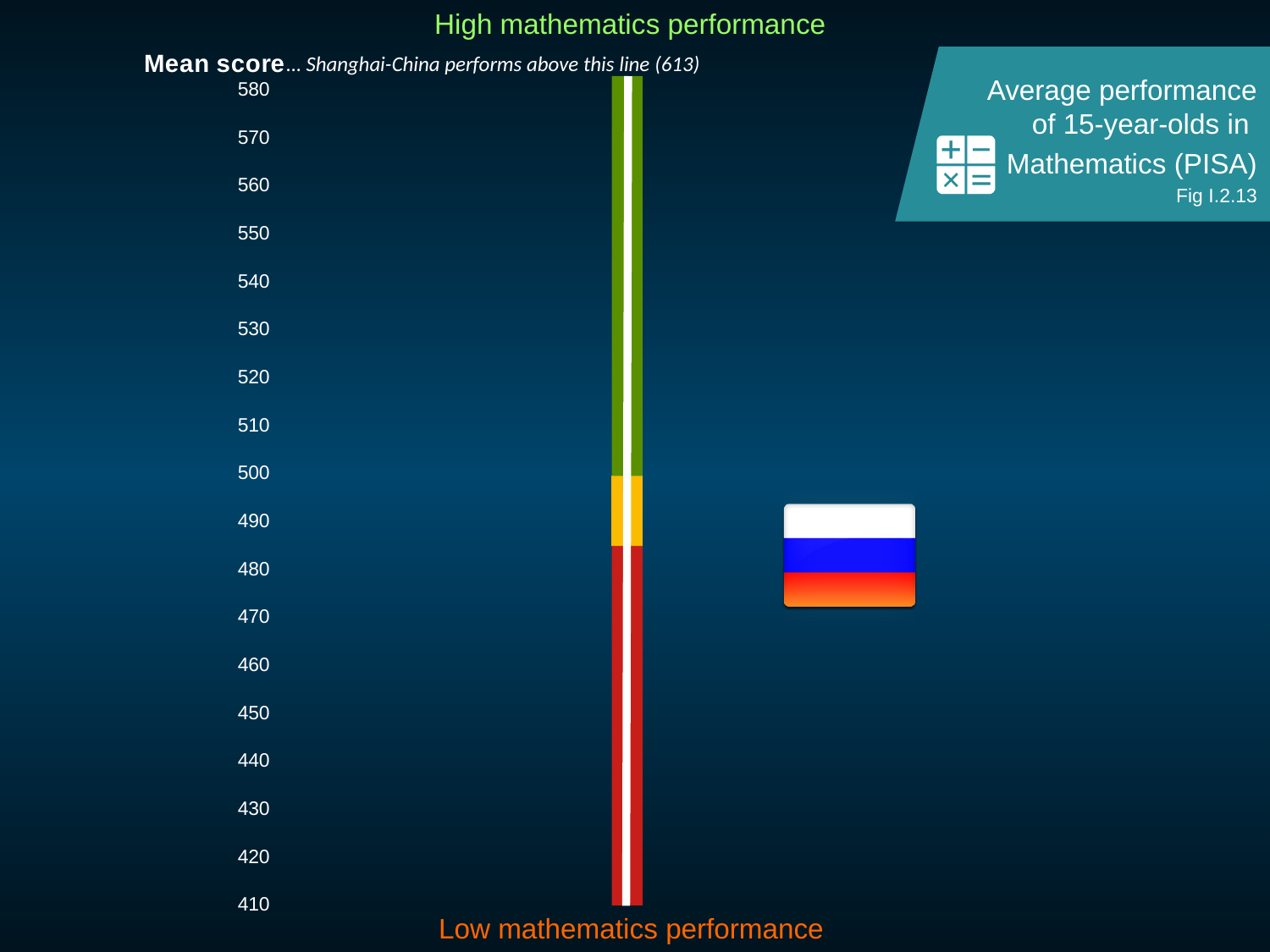
Is the position of the Russian flag on the scale greater or less than 500? less What is the lowest value shown on the vertical scale? 410 What is the interval between consecutive tick labels on the vertical scale? 10 What label appears at the bottom of the scale? Low mathematics performance How many tick labels are printed on the vertical scale? 18 Is the position of the Russian flag on the scale greater or less than 450? greater What is the figure number given in the box on the right? Fig I.2.13 Which colour is the segment of the bar at the top of the scale, above 500? Green What is the highest value shown on the vertical scale? 580 Is the position of the Russian flag on the scale greater or less than 530? less What label appears at the top of the scale? High mathematics performance According to the note at the top of the chart, what mean score does Shanghai-China perform above? 613